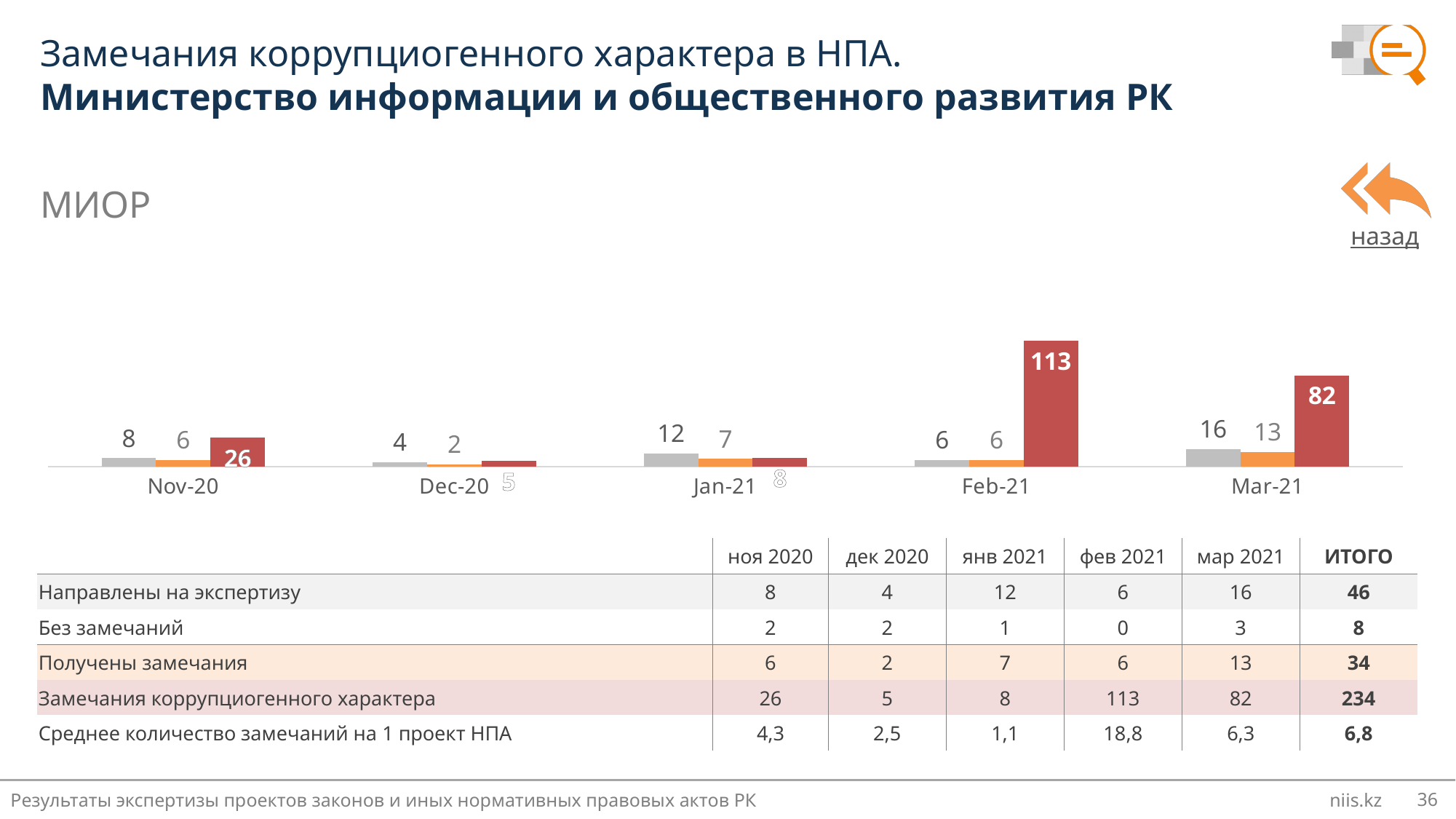
What is the difference between the red bar values for Feb-21 and Mar-21? 31 Which month has the lowest grey bar? Dec-20 What is the value of the red bar for Mar-21? 82 What type of chart is shown on the slide? bar chart What is the value of the red bar for Feb-21? 113 What is the value of the orange bar for Mar-21? 13 How many bars are shown for each month in the chart? 3 What is the value of the grey bar for Jan-21? 12 Do the grey bar values rise or fall from Feb-21 to Mar-21? rise Is the grey bar for Mar-21 larger or smaller than the grey bar for Jan-21? larger Which month has the highest red bar? Feb-21 How many months are shown on the x axis of the chart? 5